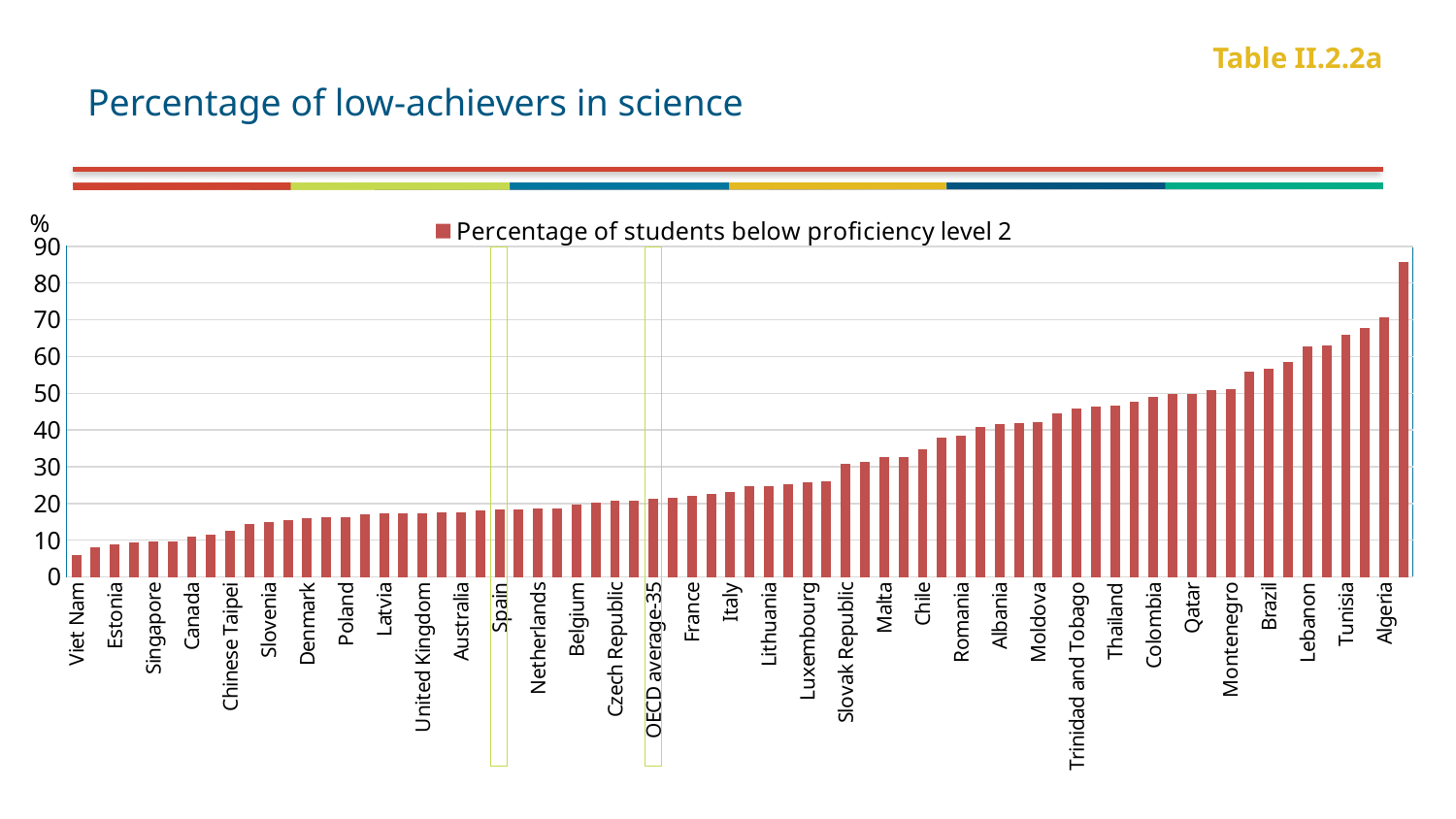
Is the value for Chile greater or less than 30? greater Is the value for Algeria greater or less than 80? less Is the value for Spain greater or less than 20? less What is the legend entry for the series shown in the chart? Percentage of students below proficiency level 2 Do the values generally rise or fall moving from left to right along the x axis? Rise Which has a higher percentage of low-achievers in science, Brazil or Spain? Brazil Which country has the lowest percentage of low-achievers in science? Viet Nam What kind of chart is shown on the slide? Bar chart How many series does the legend list? 1